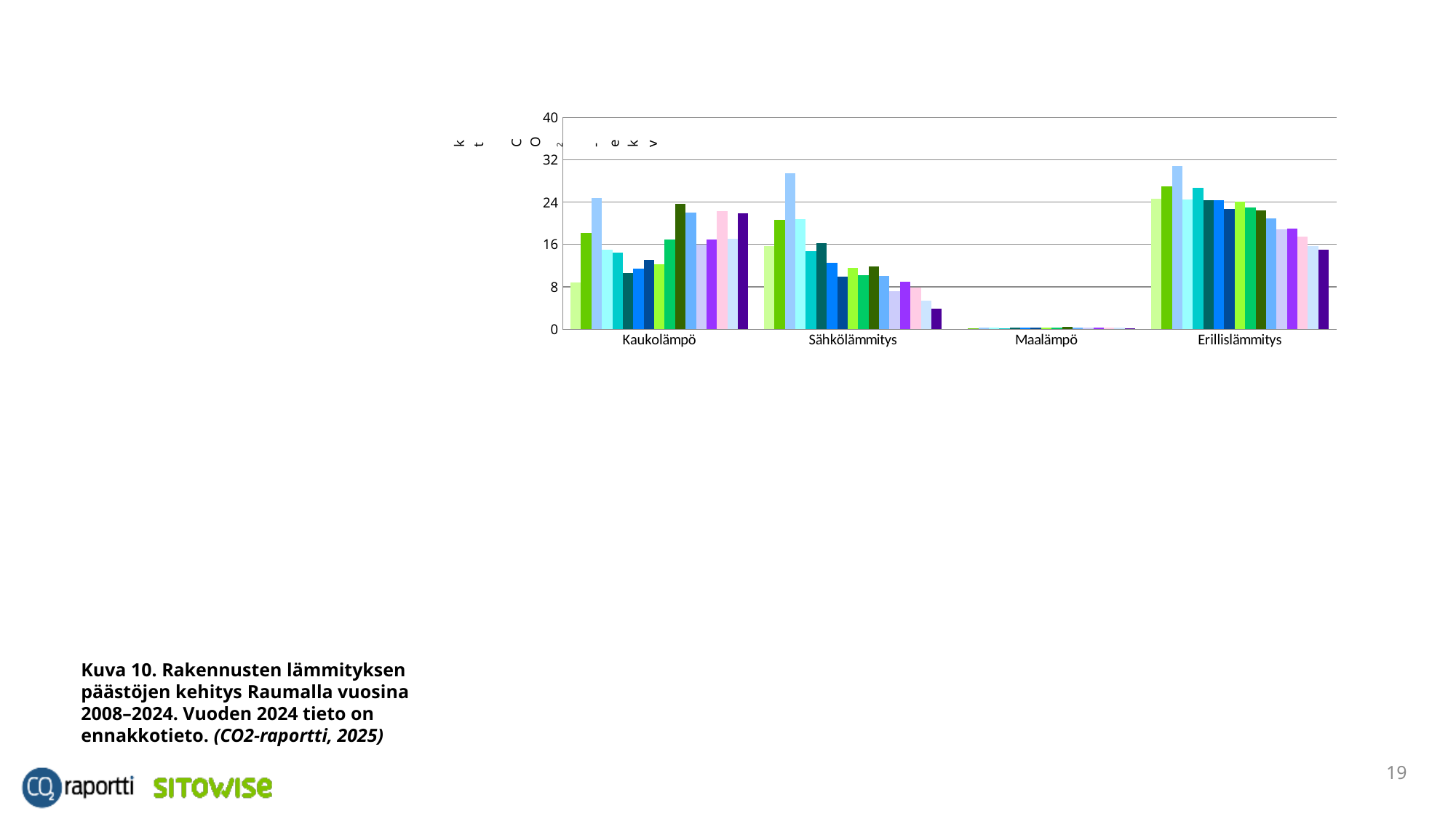
What is the label of the first category on the x axis? Kaukolämpö Which group has the taller tallest bar, Erillislämmitys or Kaukolämpö? Erillislämmitys Is the shortest bar in the Erillislämmitys group greater or less than 8? greater What kind of chart is shown on the slide? bar chart Within the Erillislämmitys group, do the bars generally rise or fall from left to right? fall Is the tallest bar in the Sähkölämmitys group greater or less than 24? greater How many heating categories are shown on the x axis of the chart? 4 Are all the bars in the Maalämpö group greater or less than 8? less Which category on the x axis has the lowest emissions across all its bars? Maalämpö What is the highest value shown on the y axis of the chart? 40